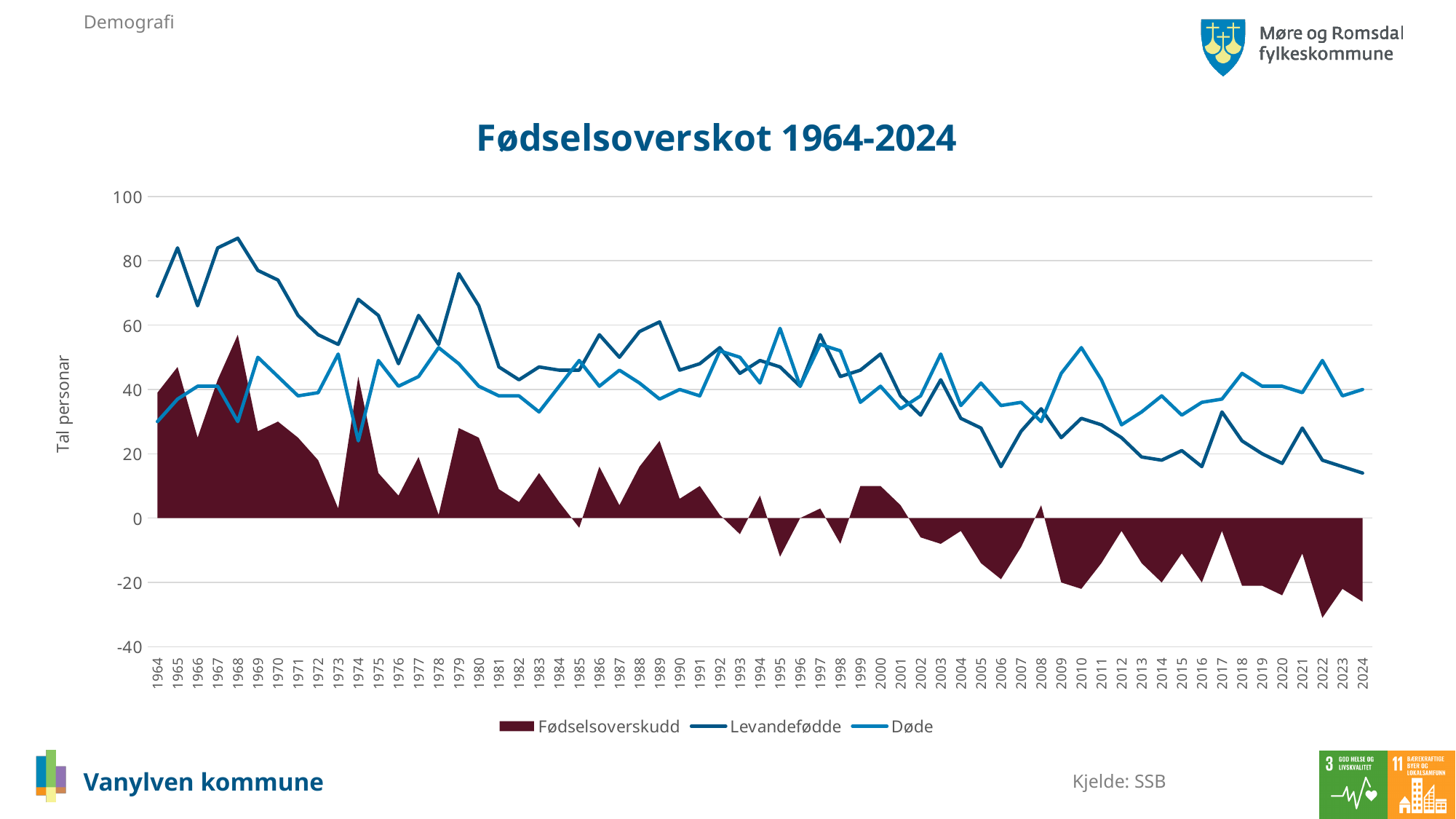
Is the value for Levandefødde in 2024 greater or less than 20? less What is the title of the chart? Fødselsoverskot 1964-2024 In 1964, which is higher, Levandefødde or Døde? Levandefødde What is the label on the vertical axis? Tal personar In which year is Levandefødde at its highest? 1968 Is the value for Fødselsoverskudd in 1968 greater or less than 40? greater Does the Levandefødde series generally rise or fall from 1964 to 2024? fall Is the value for Døde in 2010 greater or less than 40? greater In which year is Fødselsoverskudd at its lowest? 2022 How many series does the legend list? 3 In 2024, which is higher, Levandefødde or Døde? Døde